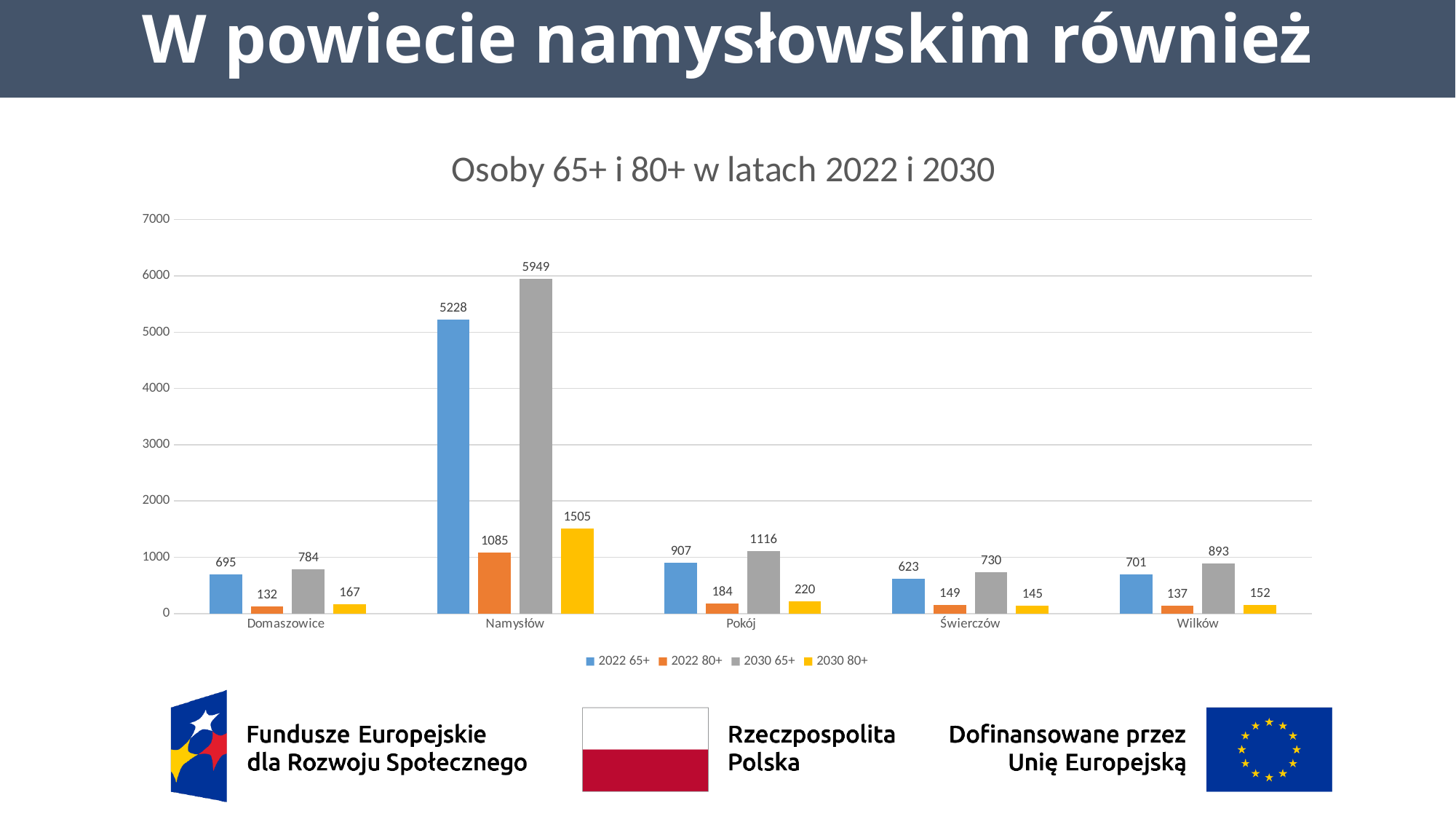
What is the difference between the 2030 65+ and 2022 65+ values for Namysłów? 721 Is the value for 2030 65+ in Pokój greater or less than 1000? greater How many categories are shown on the x axis? 5 Which category has the lowest value for 2022 65+? Świerczów What is the value for 2022 65+ in Namysłów? 5228 What kind of chart is shown on the slide? bar chart Which category has the highest value for 2030 65+? Namysłów What is the value for 2030 80+ in Pokój? 220 Which is larger: the 2030 80+ value for Domaszowice or for Wilków? Domaszowice What is the value for 2022 80+ in Wilków? 137 How many series does the legend list? 4 What is the title of the chart? Osoby 65+ i 80+ w latach 2022 i 2030